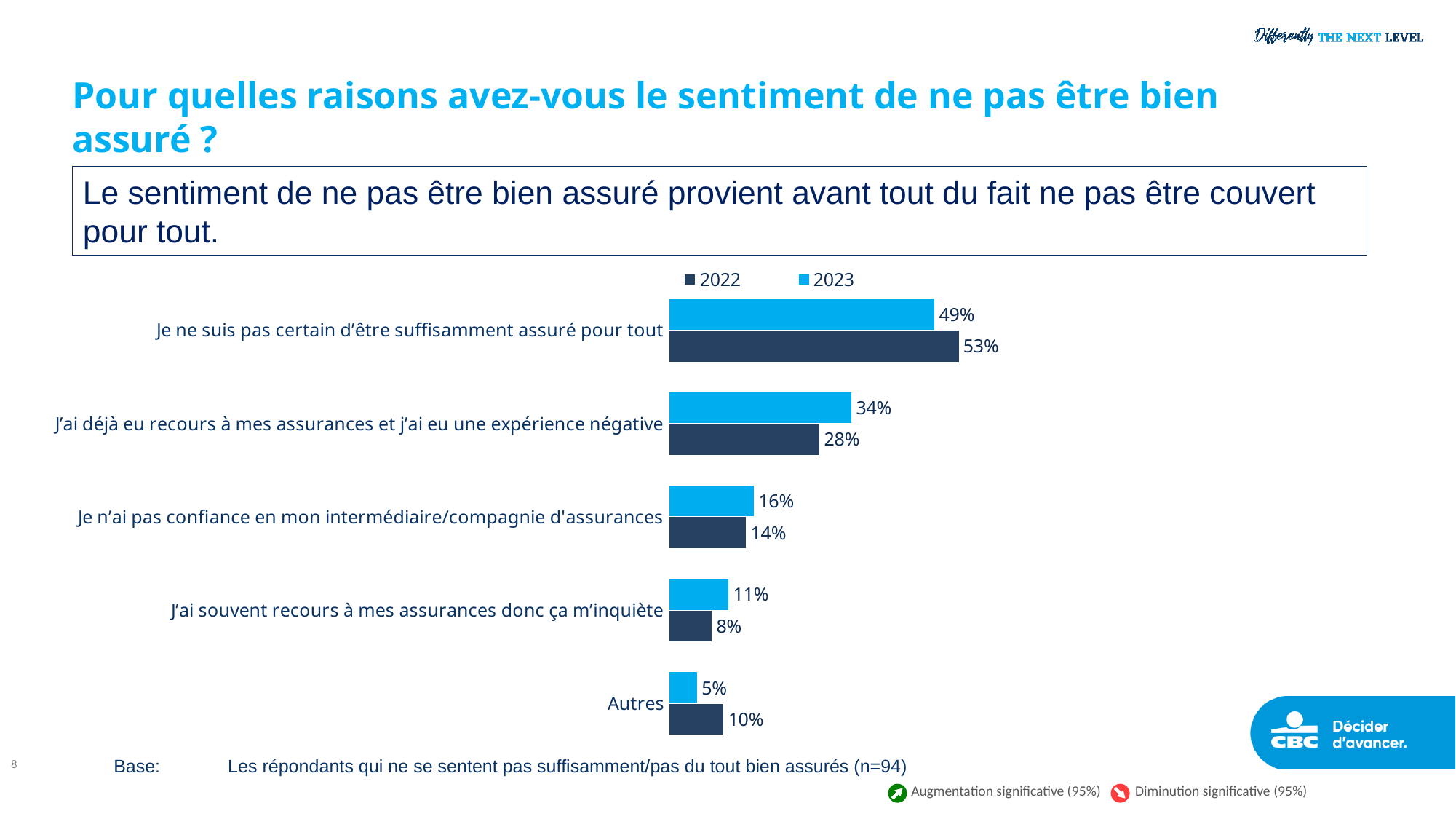
For "Autres", which year has the larger value, 2022 or 2023? 2022 For "J'ai souvent recours à mes assurances donc ça m'inquiète", which year has the larger value, 2022 or 2023? 2023 What is the difference between the 2022 and 2023 values for "Je ne suis pas certain d'être suffisamment assuré pour tout"? 4% Which category has the lowest 2023 value? Autres How many series does the legend list? 2 What is the 2023 value for "Je ne suis pas certain d'être suffisamment assuré pour tout"? 49% How many categories are shown in the chart? 5 What is the 2023 value for "Autres"? 5% Which category has the highest 2022 value? Je ne suis pas certain d'être suffisamment assuré pour tout What is the 2022 value for "J'ai déjà eu recours à mes assurances et j'ai eu une expérience négative"? 28% What is the difference between the 2023 and 2022 values for "J'ai déjà eu recours à mes assurances et j'ai eu une expérience négative"? 6% What kind of chart is shown on the slide? Bar chart